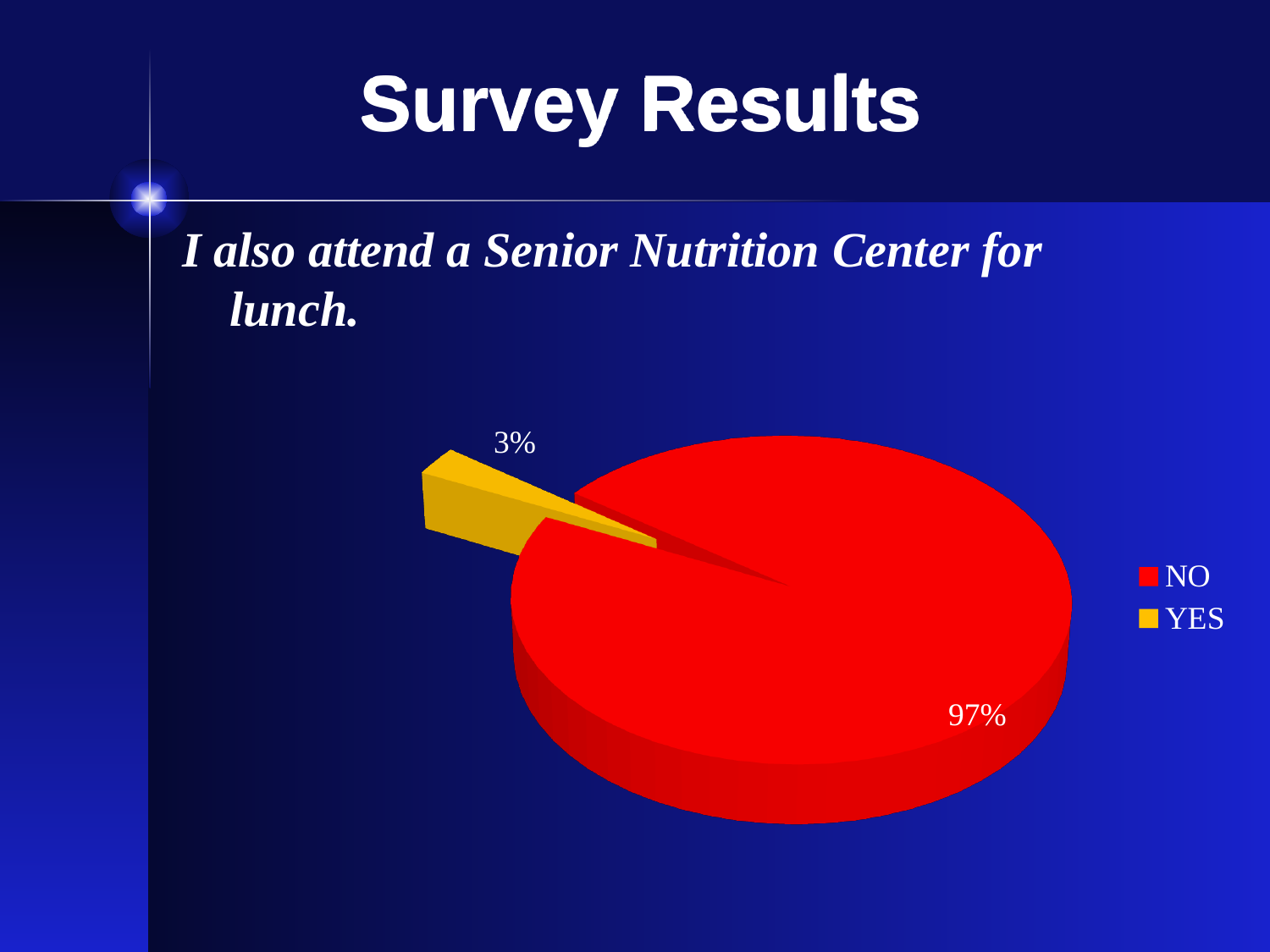
How many entries does the legend list? 2 What survey statement does the pie chart summarise? I also attend a Senior Nutrition Center for lunch. What percentage of respondents answered NO? 97% Which response has the smallest share of the pie? YES What kind of chart is shown on the slide? pie chart What is the difference in percentage points between the NO and YES slices? 94 What percentage of respondents answered YES? 3% How many slices does the pie chart have? 2 What colour is the NO slice? red Which response has the largest share of the pie? NO Which slice is larger, NO or YES? NO What share of the pie does the YES slice represent? 3%